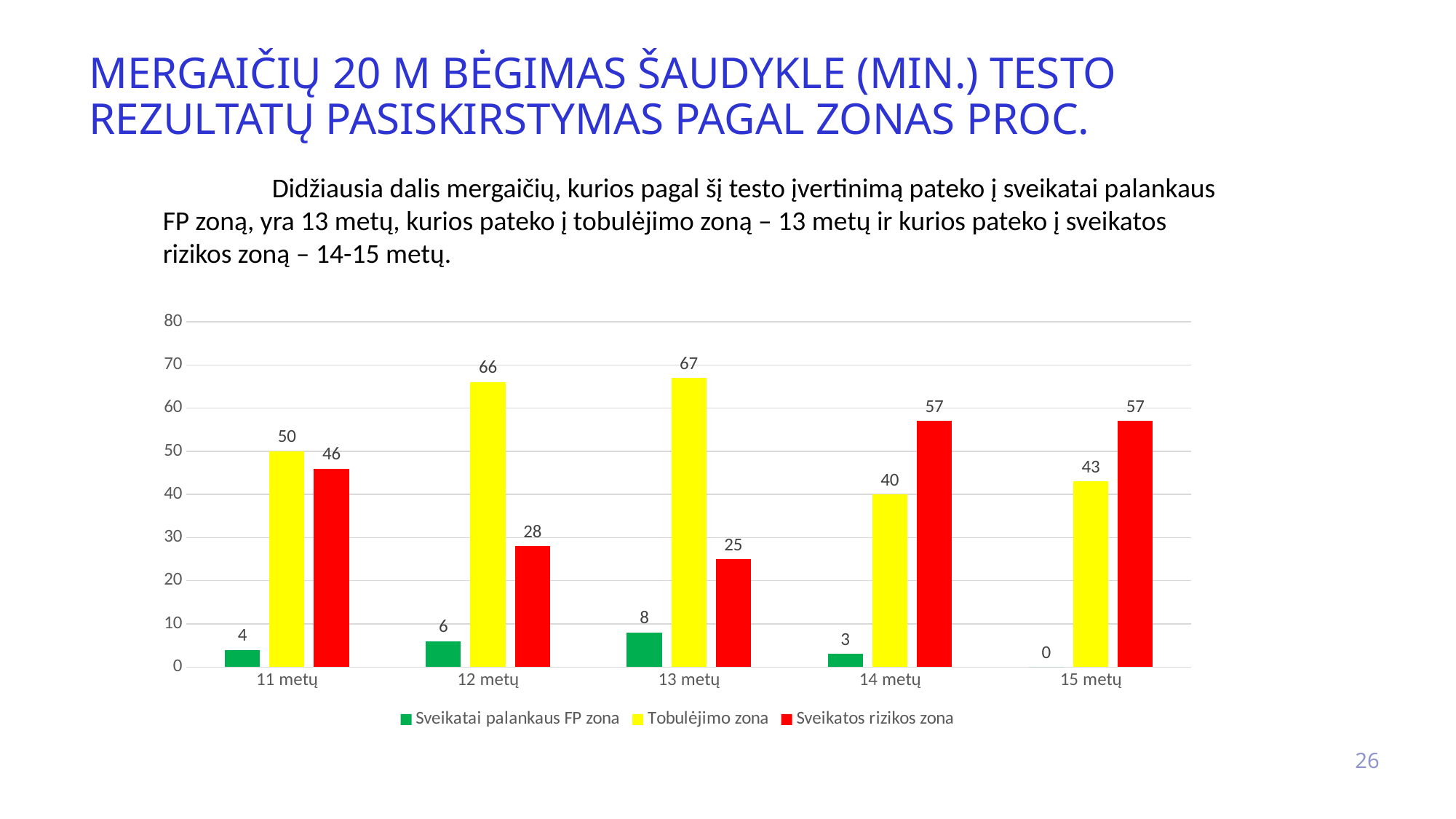
Which colour represents Sveikatos rizikos zona in the legend? red What is the value for Tobulėjimo zona at 13 metų? 67 Is the value for Tobulėjimo zona at 12 metų greater or less than 60? greater How many series does the legend list? 3 Which is larger at 14 metų: Tobulėjimo zona or Sveikatos rizikos zona? Sveikatos rizikos zona How many age groups are shown on the x axis? 5 Which age group has the lowest value for Tobulėjimo zona? 14 metų Which age group has the highest value for Sveikatai palankaus FP zona? 13 metų What is the difference between Tobulėjimo zona and Sveikatos rizikos zona at 12 metų? 38 What is the value for Sveikatai palankaus FP zona at 15 metų? 0 What is the value for Sveikatos rizikos zona at 11 metų? 46 What kind of chart is shown on the slide? bar chart